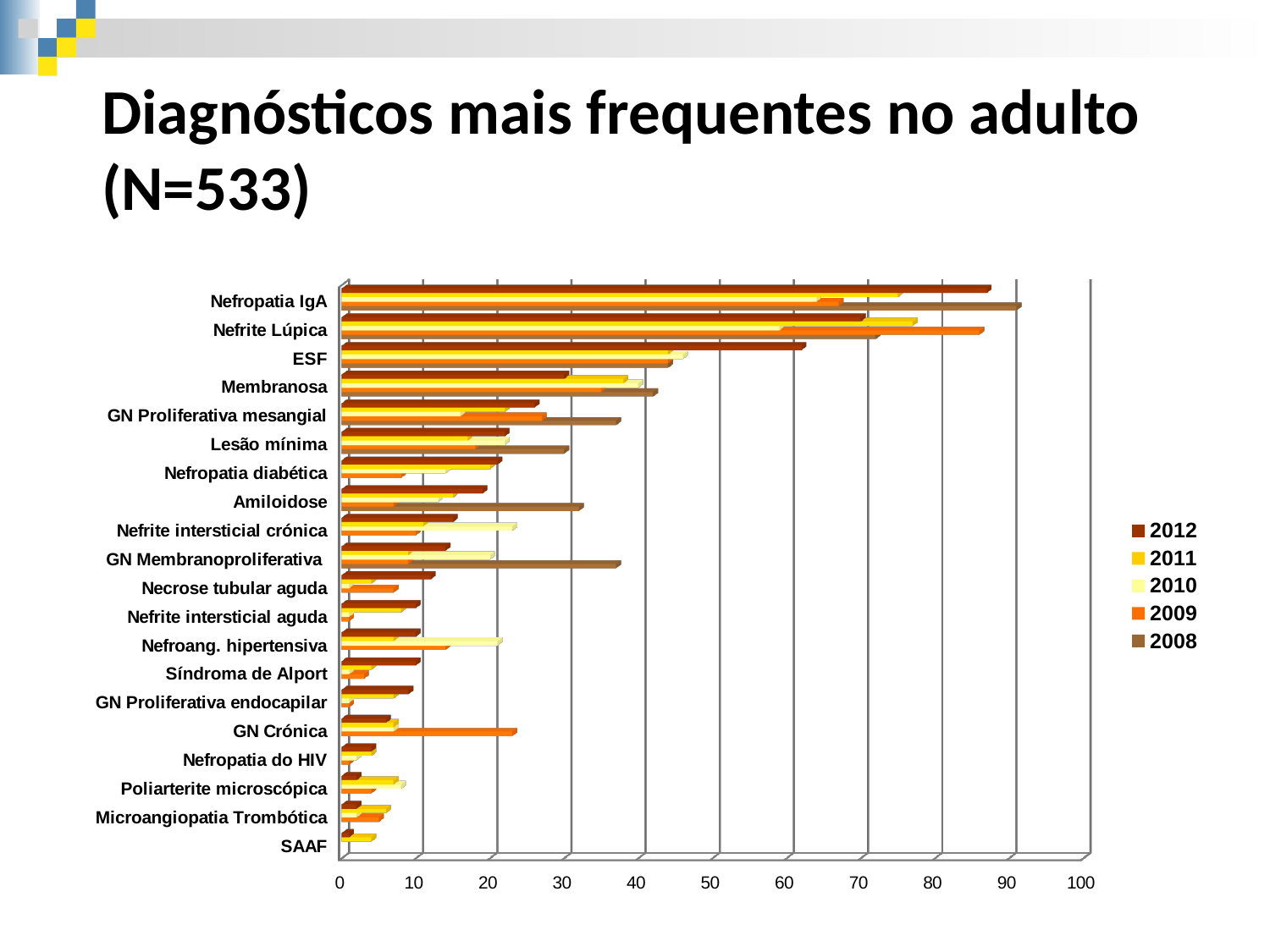
Is the 2009 value for Nefrite Lúpica greater or less than 80? greater How many series does the legend list? 5 For GN Crónica, which year has the larger value: 2009 or 2012? 2009 Is the 2012 value for Membranosa greater or less than 40? less How many diagnosis categories are listed on the chart? 20 Is the 2012 value for Nefropatia IgA greater or less than 80? greater Which years are listed in the chart legend? 2012, 2011, 2010, 2009, 2008 Which diagnosis has the highest 2012 value? Nefropatia IgA For 2012, which is larger: Nefropatia IgA or Nefrite Lúpica? Nefropatia IgA What kind of chart is shown on the slide? Bar chart For Nefroang. hipertensiva, which year has the larger value: 2010 or 2012? 2010